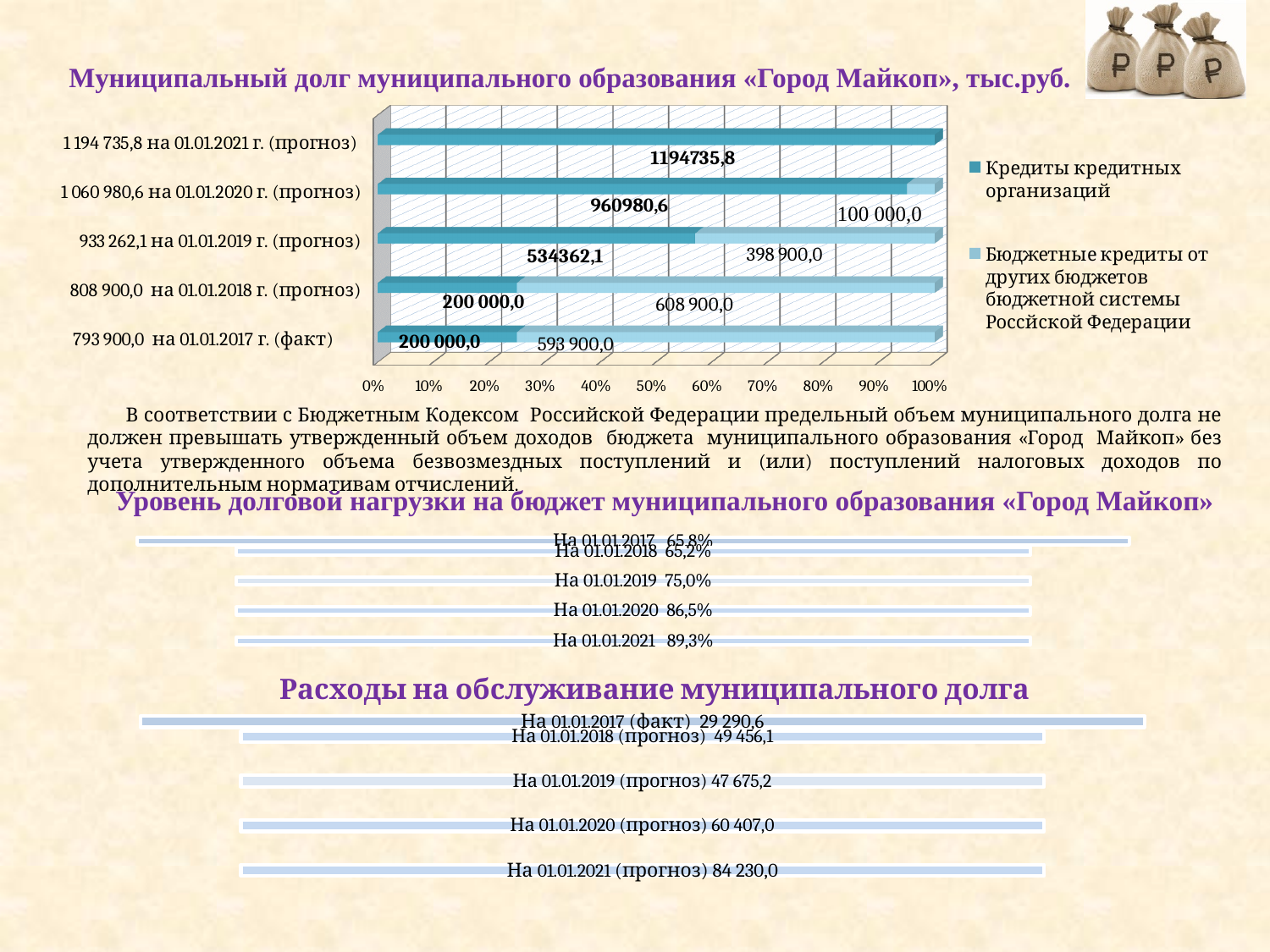
What type of chart is shown on the slide? bar chart How many series does the chart legend list? 2 How many dates (categories) are plotted in the chart? 5 On 01.01.2019 (прогноз), which is larger: «Кредиты кредитных организаций» or «Бюджетные кредиты от других бюджетов»? Кредиты кредитных организаций Does the value of «Кредиты кредитных организаций» rise or fall from 01.01.2017 to 01.01.2021? rise On which date is the value of «Бюджетные кредиты от других бюджетов бюджетной системы Российской Федерации» the highest? 01.01.2018 (прогноз) What is the value of «Кредиты кредитных организаций» on 01.01.2021 (прогноз)? 1194735,8 On which date is the value of «Кредиты кредитных организаций» the highest? 01.01.2021 (прогноз) What is the total municipal debt on 01.01.2019 (прогноз), summing both series? 933 262,1 What is the value of «Бюджетные кредиты от других бюджетов бюджетной системы Российской Федерации» on 01.01.2020 (прогноз)? 100 000,0 What is the difference between the budget credits on 01.01.2018 (608 900,0) and on 01.01.2017 (593 900,0)? 15 000,0 What is the value of «Кредиты кредитных организаций» on 01.01.2017 (факт)? 200 000,0